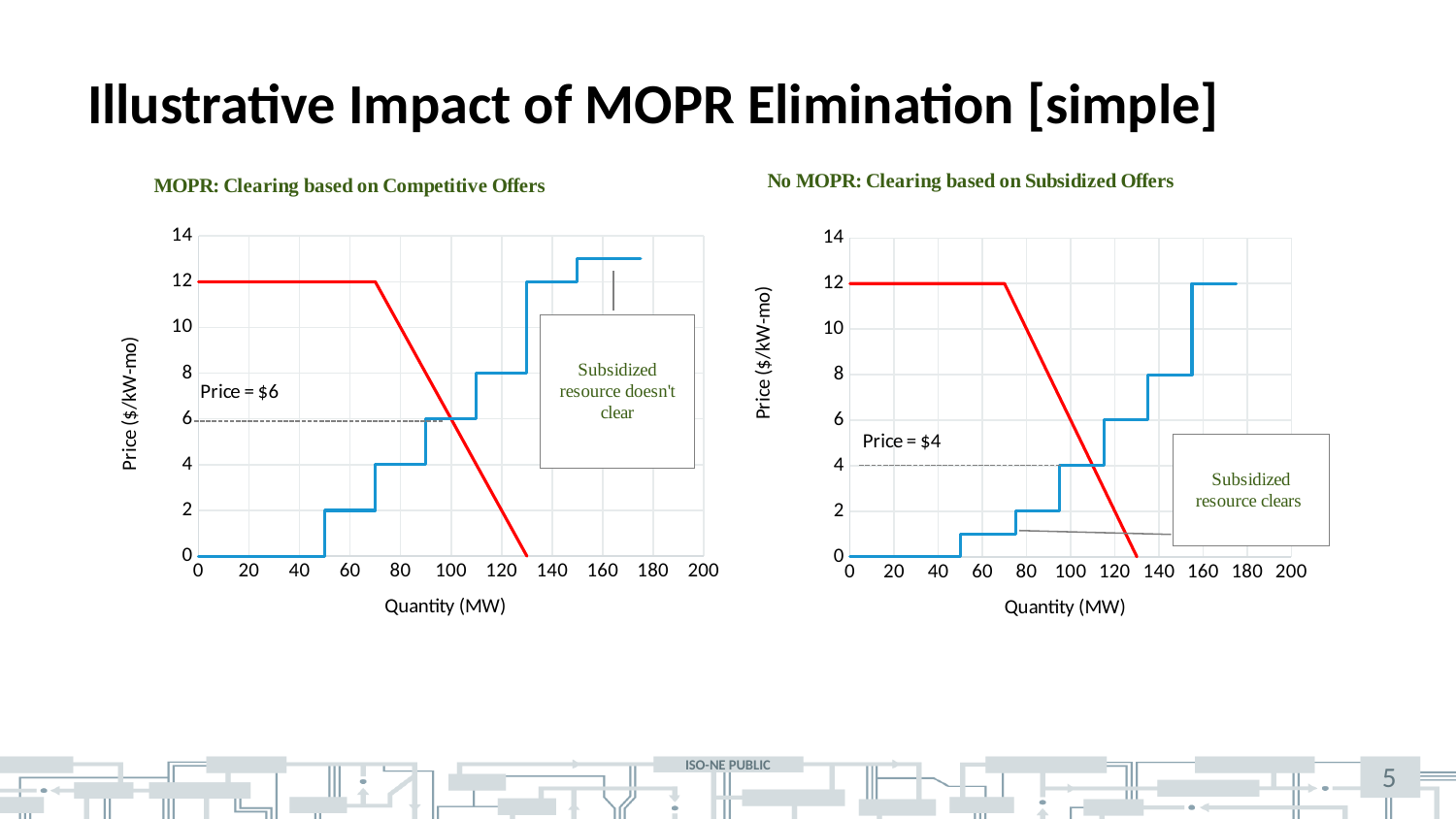
In the left chart (MOPR: Clearing based on Competitive Offers), what clearing price is labeled on the chart? Price = $6 What is the difference between the labeled clearing price in the left chart and the labeled clearing price in the right chart? $2 In the left chart, is the highest step of the blue line greater or less than 12? greater What is the title of the chart on the right side of the slide? No MOPR: Clearing based on Subsidized Offers In the right chart, does the red line rise or fall as quantity increases beyond 70 MW? Fall What kind of chart is shown on the left side of the slide? Line chart How many charts are shown on the slide? 2 In the right chart, is the labeled clearing price greater or less than 6? less What does the text box in the left chart say about the subsidized resource? Subsidized resource doesn't clear In the left chart, at what price level is the flat portion of the red line? 12 Which chart shows the higher labeled clearing price, the MOPR chart on the left or the No MOPR chart on the right? MOPR chart on the left In the right chart (No MOPR: Clearing based on Subsidized Offers), what clearing price is labeled on the chart? Price = $4